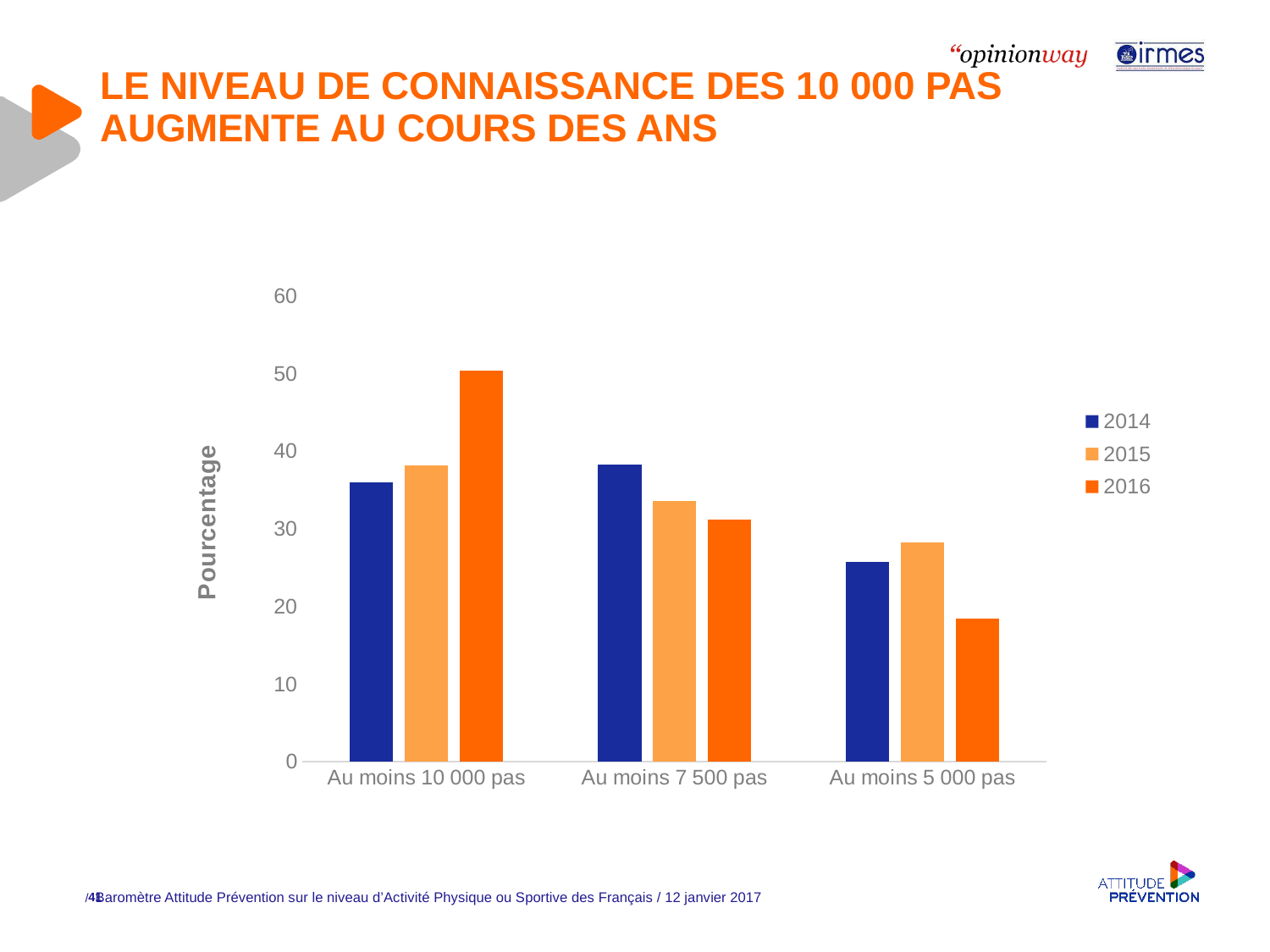
Is the 2016 value for "Au moins 5 000 pas" greater or less than 20? less Which series is shown in dark blue in the legend? 2014 Which series has the lowest value for "Au moins 5 000 pas"? 2016 For "Au moins 7 500 pas", which is larger: the 2014 value or the 2016 value? 2014 What kind of chart is shown on the slide? bar chart How many series does the legend list? 3 Which series has the highest value for "Au moins 10 000 pas"? 2016 How many categories are shown on the x axis? 3 Is the 2014 value for "Au moins 7 500 pas" greater or less than 30? greater What is the label of the vertical axis? Pourcentage Do the 2016 values rise or fall moving from "Au moins 10 000 pas" to "Au moins 5 000 pas" along the x axis? fall